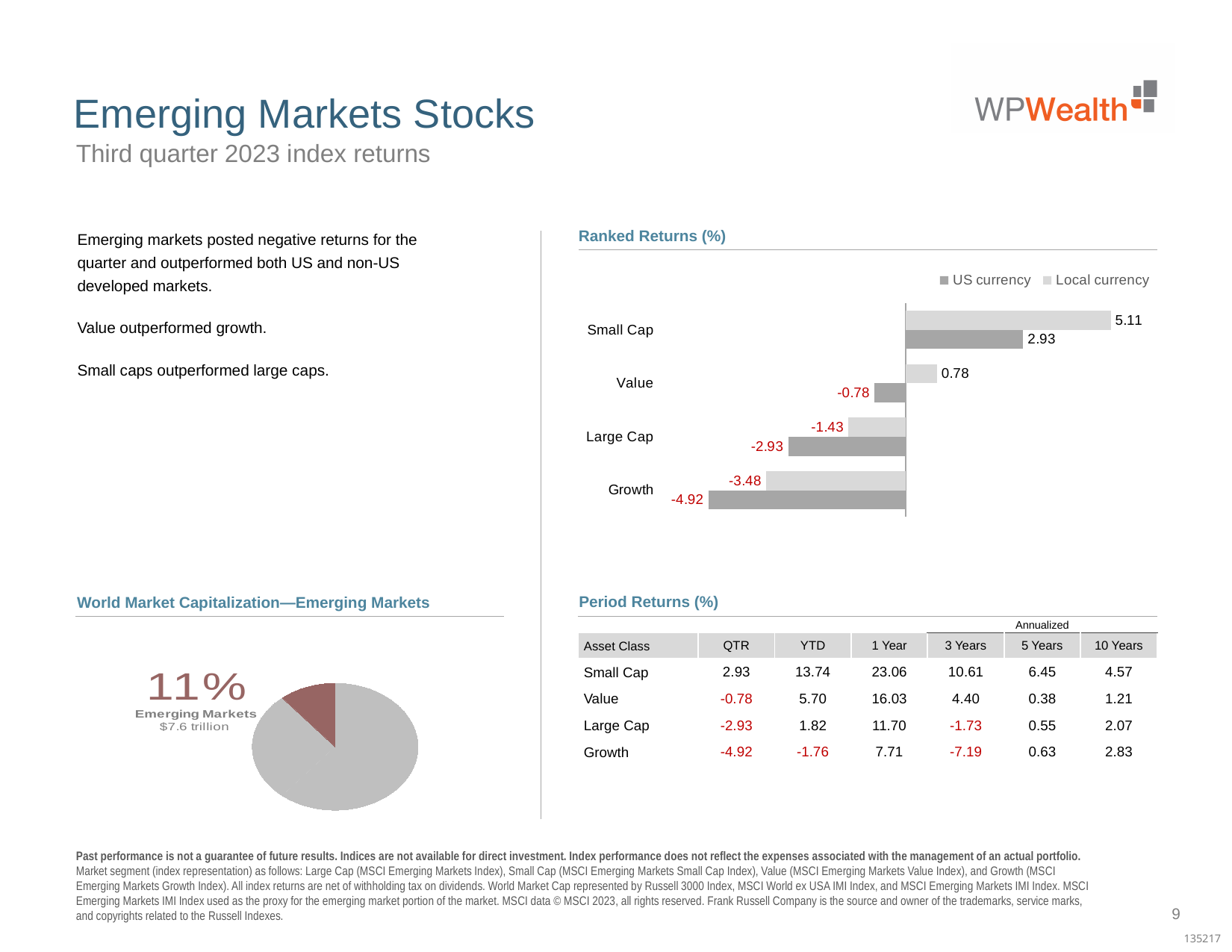
How many categories are shown in the Ranked Returns (%) chart? 4 In the Ranked Returns (%) chart, which category has the highest Local currency return? Small Cap In the Ranked Returns (%) chart, what is the difference between the Local currency and US currency returns for Small Cap? 2.18 In the Ranked Returns (%) chart, which category has the lowest US currency return? Growth What kind of chart is the Ranked Returns (%) chart? Bar chart In the World Market Capitalization—Emerging Markets pie chart, what dollar value is shown for Emerging Markets? $7.6 trillion How many series does the legend of the Ranked Returns (%) chart list? 2 In the World Market Capitalization—Emerging Markets pie chart, what share of world market capitalization do Emerging Markets represent? 11% In the Ranked Returns (%) chart, what is the Local currency return for Value? 0.78 In the Ranked Returns (%) chart, which is larger: the US currency return for Large Cap or the US currency return for Value? Value In the Ranked Returns (%) chart, what is the US currency return for Small Cap? 2.93 In the Ranked Returns (%) chart, what is the Local currency return for Growth? -3.48